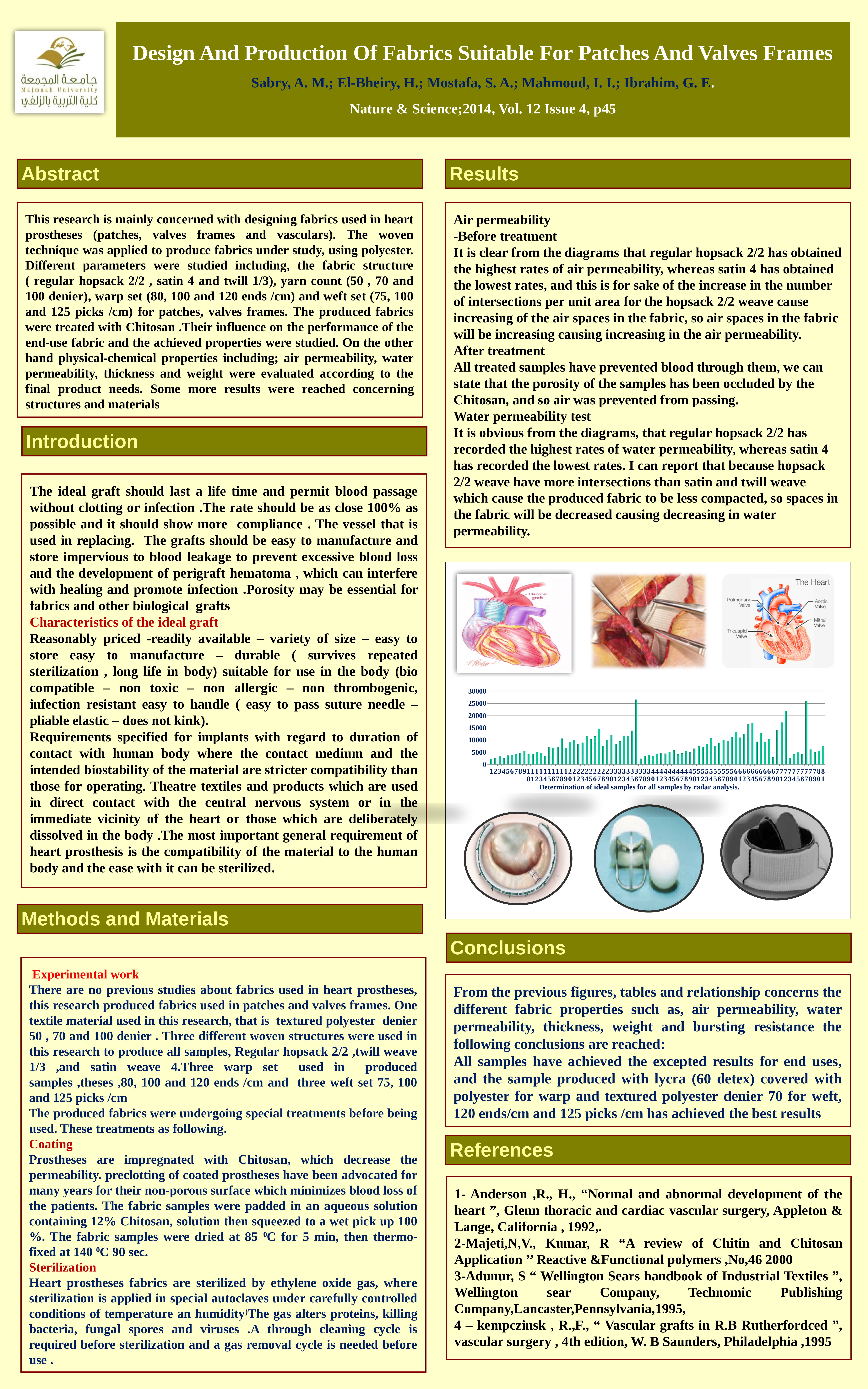
What is the highest value shown on the y axis of the bar chart? 30000 What kind of chart is shown below the heart images on the right side of the slide? bar chart In the bar chart, is the tallest bar greater or less than 25000? greater In the bar chart, is the value for category 81 greater or less than 10000? less In the bar chart, is the value for category 1 greater or less than 5000? less What caption is printed beneath the bar chart? Determination of ideal samples for all samples by radar analysis. How many categories are plotted along the x axis of the bar chart? 81